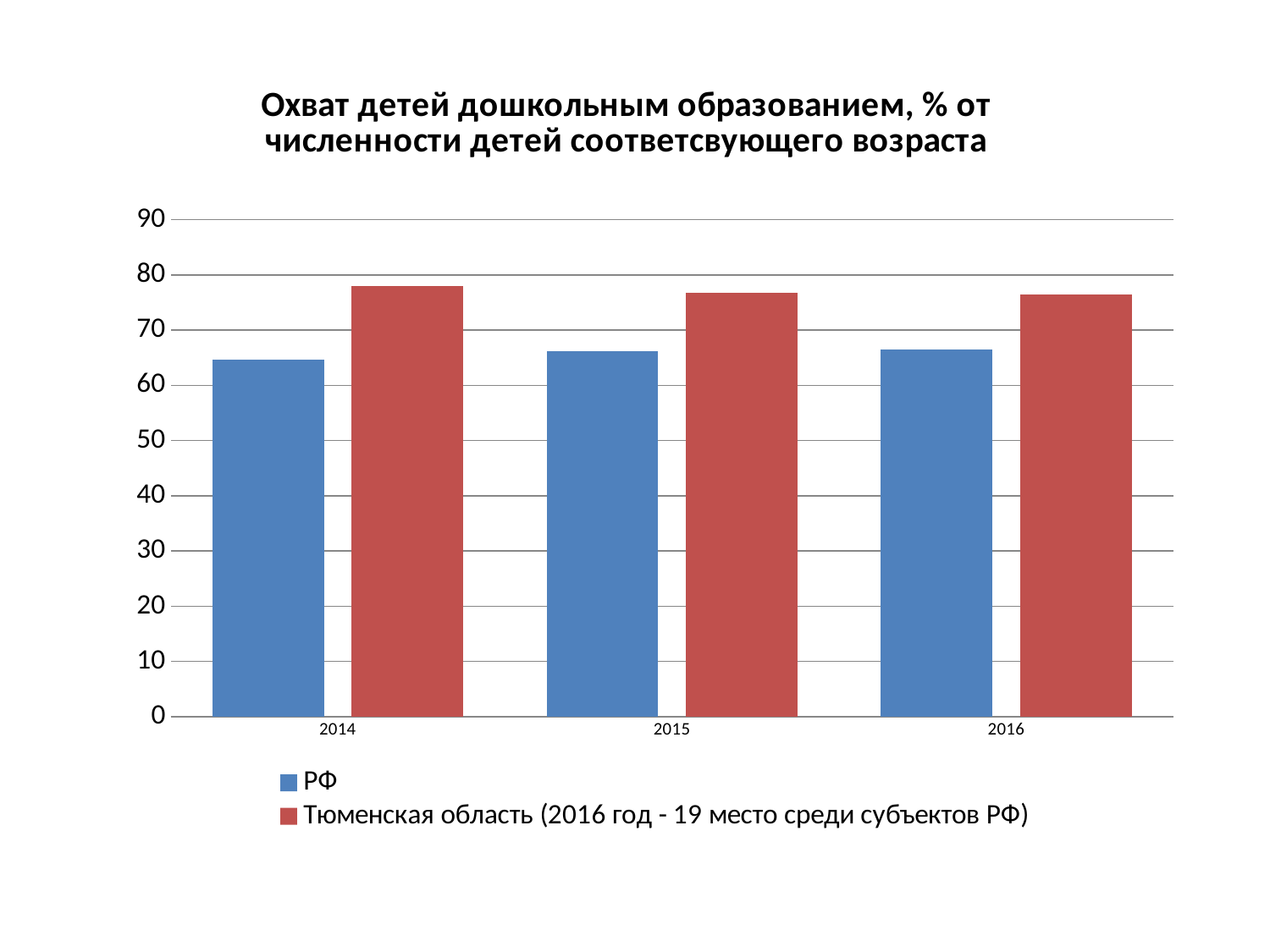
Is the value for Тюменская область in 2015 greater or less than 70? greater In which year is the value for РФ the lowest? 2014 Which is larger in 2016, the value for РФ or for Тюменская область? Тюменская область How many series does the legend list? 2 What colour are the bars for Тюменская область? red Which is larger in 2014, the value for РФ or for Тюменская область? Тюменская область What kind of chart is shown on the slide? bar chart Do the values for РФ rise or fall from 2014 to 2016? rise How many years are shown on the x axis? 3 Is the value for РФ in 2014 greater or less than 60? greater Is the value for Тюменская область in 2014 greater or less than 80? less